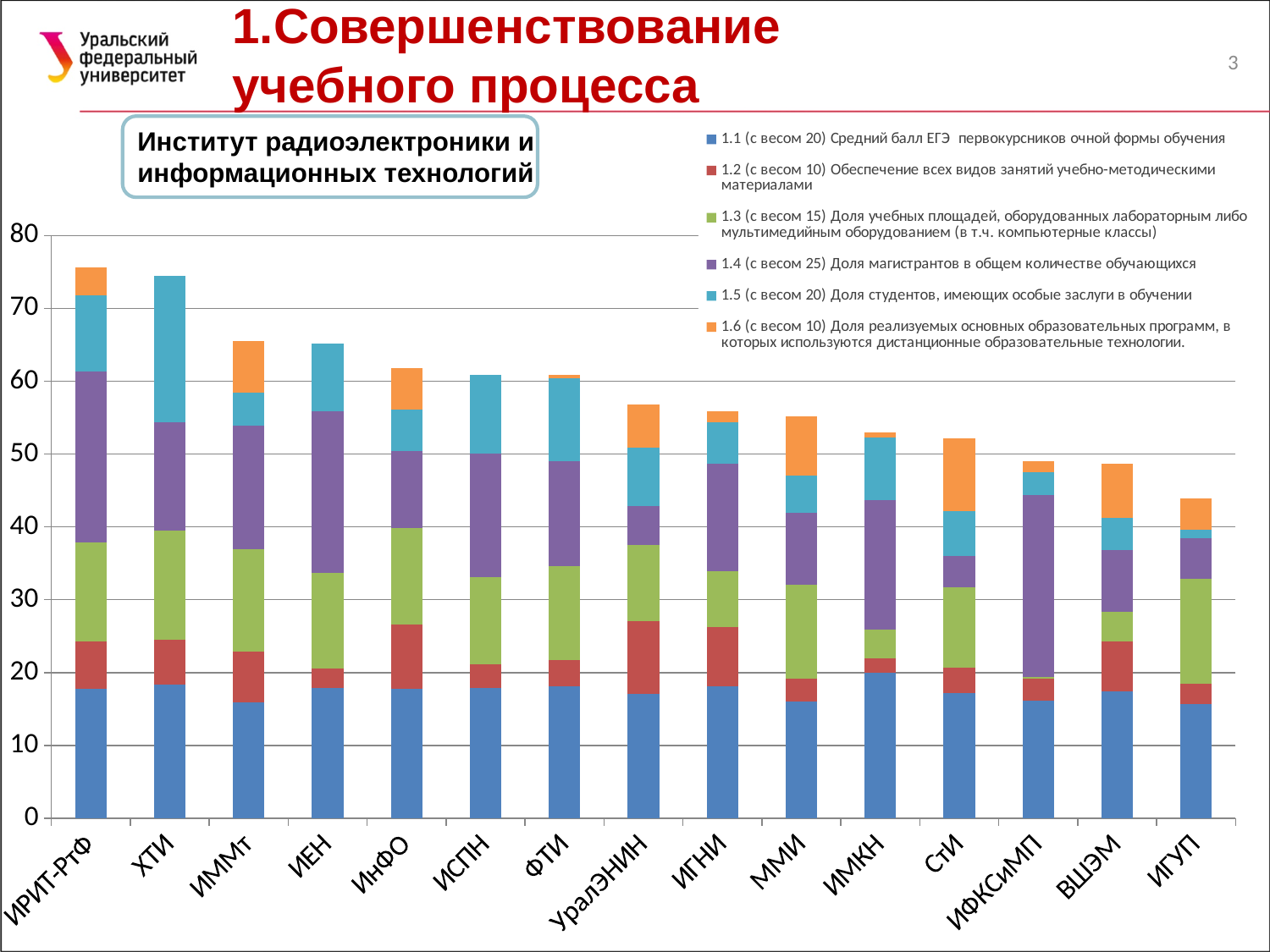
Is the total bar for ИЕН greater or less than 60? greater Which legend entry is shown in purple? 1.4 (с весом 25) Доля магистрантов в общем количестве обучающихся What kind of chart is shown on the slide? Stacked bar chart Which institute has the lowest total bar in the chart? ИГУП Is the total bar for ИРИТ-РтФ greater or less than 70? greater Which institute has the taller total bar, ИЕН or ИнФО? ИЕН Do the total bar heights generally rise or fall from left to right along the x axis? Fall Which institute has the taller total bar, ИМКН or ИГУП? ИМКН Is the total bar for ВШЭМ greater or less than 50? less How many series does the chart legend list? 6 How many institutes (categories) are shown along the x axis of the chart? 15